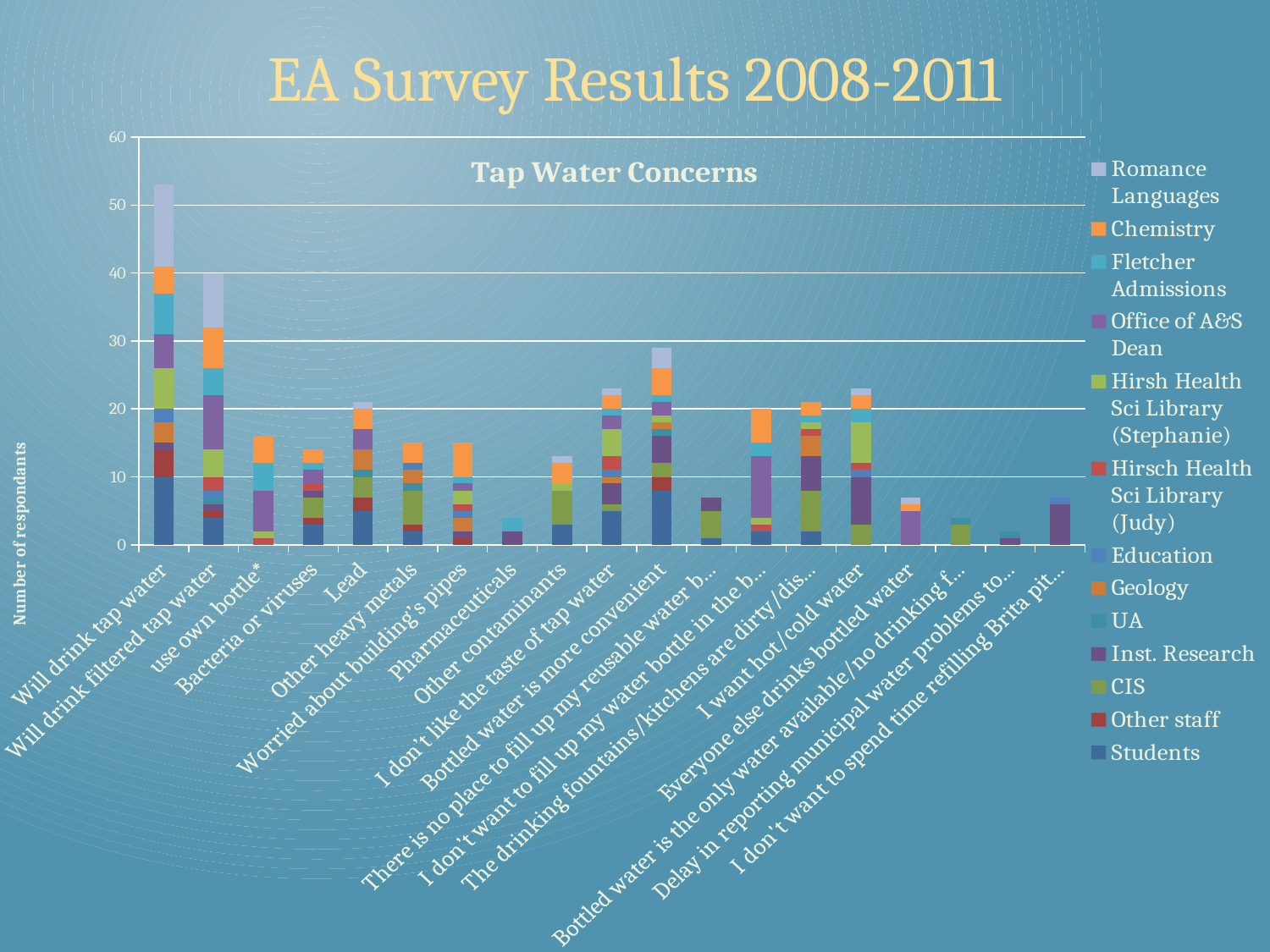
Which bar is taller: 'Lead' or 'Other heavy metals'? Lead Is the total for 'Bottled water is more convenient' greater or less than 20? greater How many categories are shown along the x axis? 19 What is the label on the vertical axis? Number of respondants What kind of chart is shown on the slide? Stacked bar chart Which category has the shortest bar? Delay in reporting municipal water problems to... What is the title of the chart? Tap Water Concerns Which bar is taller: 'Will drink tap water' or 'Will drink filtered tap water'? Will drink tap water How many series does the legend list? 13 Is the total for 'Will drink tap water' greater or less than 40? greater Which category has the tallest bar? Will drink tap water Is the total for 'Pharmaceuticals' greater or less than 10? less